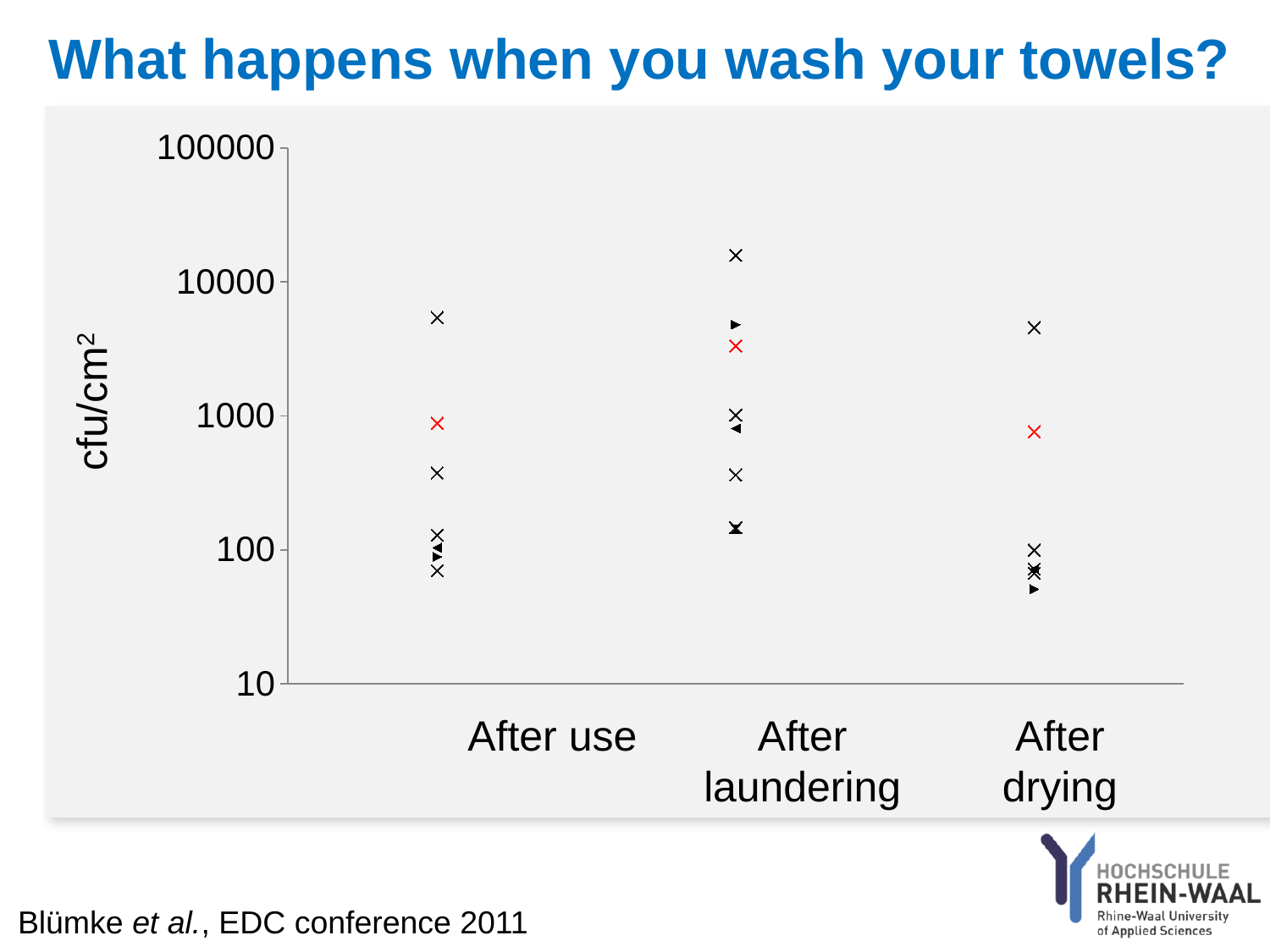
Is the lowest point in the 'After laundering' category greater or less than 100? greater Is the red marker in the 'After laundering' category greater or less than 1000? greater How many categories are shown along the x axis? 3 Is the highest point in the 'After use' category greater or less than 1000? greater What is the label of the y axis? cfu/cm² Which category contains the single highest plotted point? After laundering What is the title of the slide containing the chart? What happens when you wash your towels? What kind of chart is shown on the slide? scatter chart